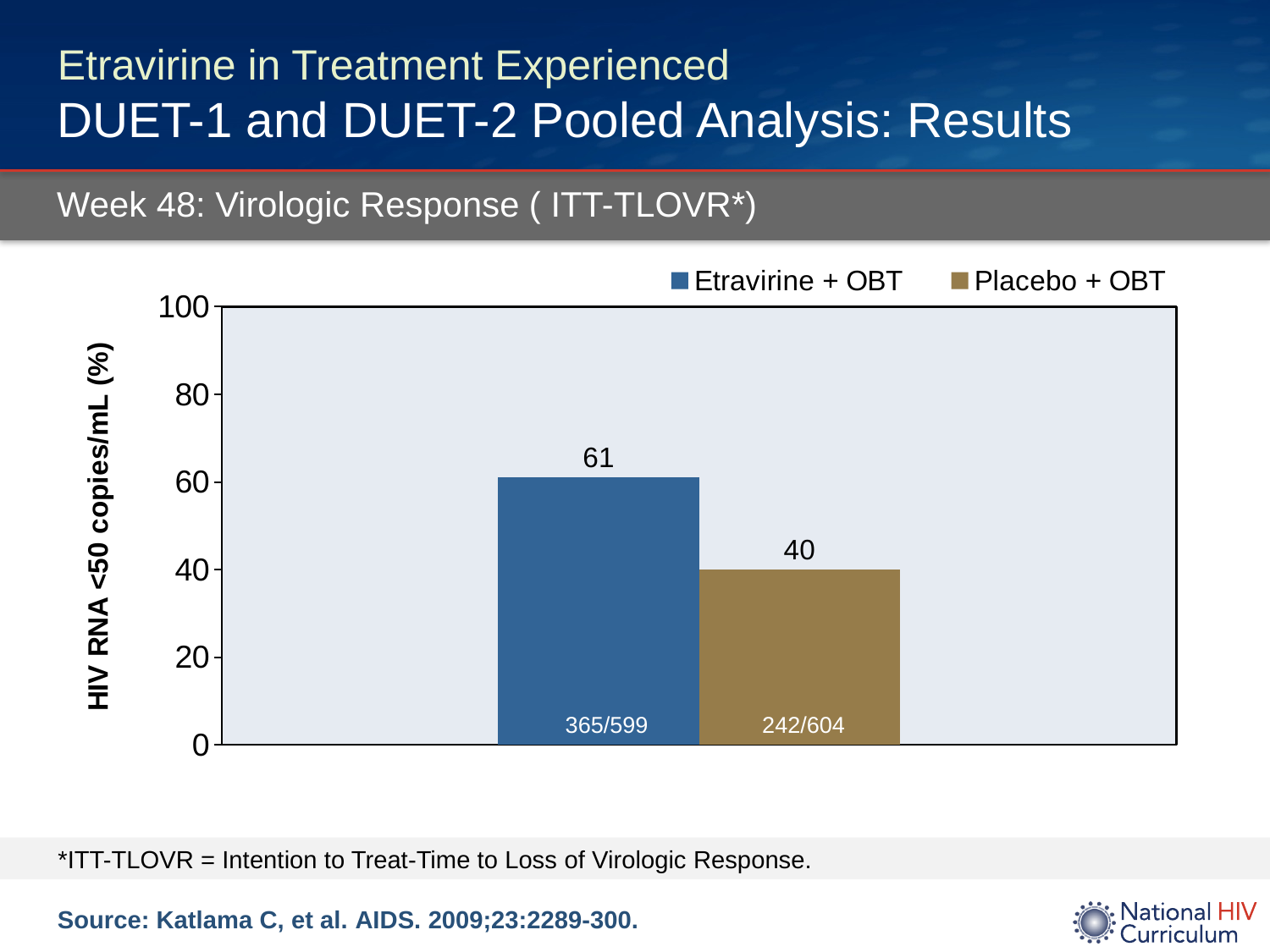
What is the y-axis label of the chart? HIV RNA <50 copies/mL (%) Which series has the highest value? Etravirine + OBT What is the value for Placebo + OBT? 40 What is the difference between the Etravirine + OBT and Placebo + OBT values? 21 Which series has the lowest value? Placebo + OBT What fraction is printed inside the Etravirine + OBT bar? 365/599 What kind of chart is shown? bar chart What fraction is printed inside the Placebo + OBT bar? 242/604 How many series does the legend list? 2 What is the value for Etravirine + OBT? 61 Which is larger, the value for Etravirine + OBT or for Placebo + OBT? Etravirine + OBT Is the value for Etravirine + OBT greater or less than 60? greater